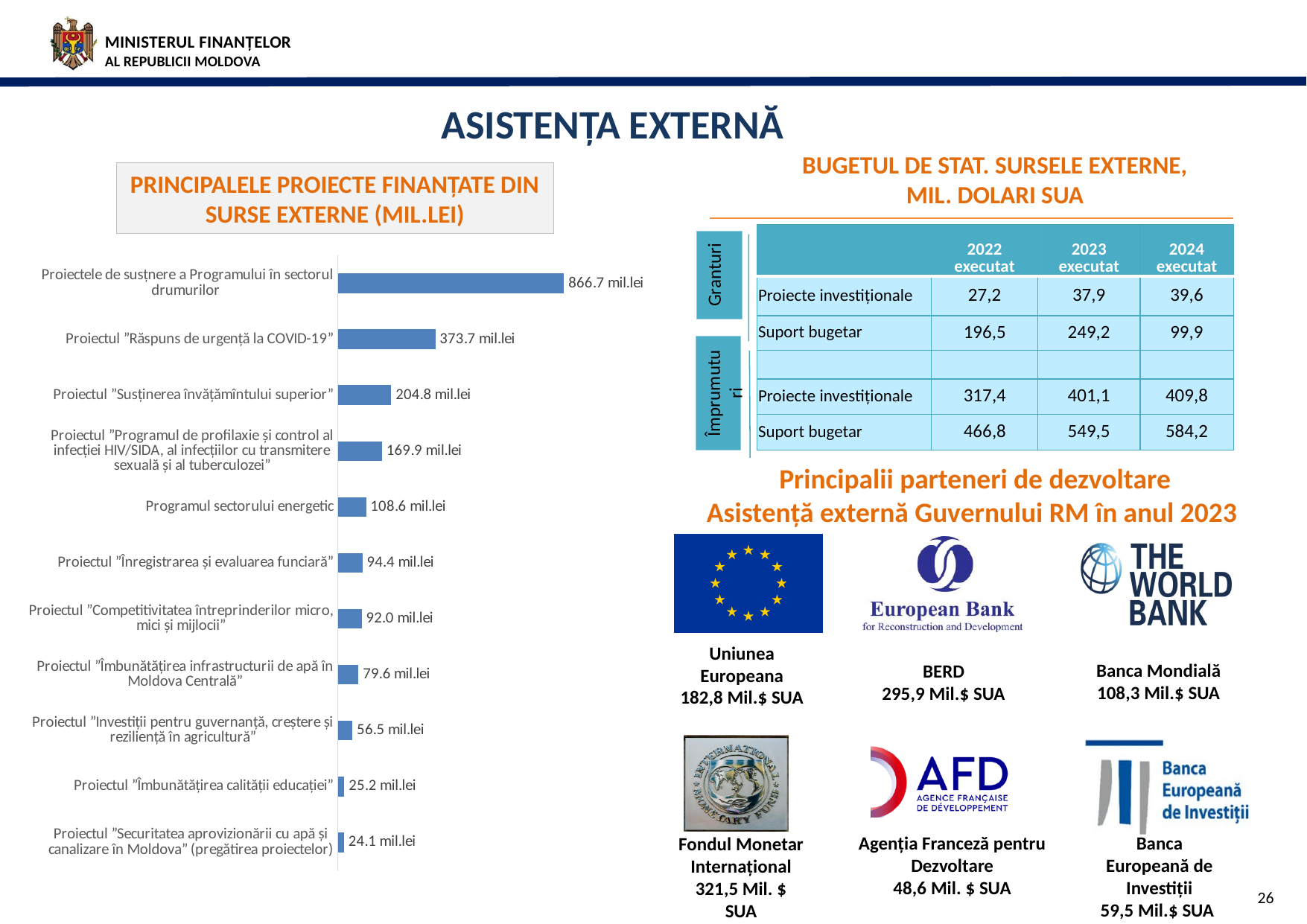
What is the value for "Proiectul "Îmbunătățirea calității educației""? 25.2 mil.lei Which is larger: the value for "Proiectul "Înregistrarea și evaluarea funciară"" or for "Proiectul "Competitivitatea întreprinderilor micro, mici și mijlocii""? Proiectul "Înregistrarea și evaluarea funciară" Which project has the lowest value in the chart? Proiectul "Securitatea aprovizionării cu apă și canalizare în Moldova" (pregătirea proiectelor) What is the value for "Programul sectorului energetic"? 108.6 mil.lei What is the value for "Proiectul "Răspuns de urgență la COVID-19""? 373.7 mil.lei How many projects are shown in the bar chart? 11 What is the difference between the value for the road sector programme (866.7 mil.lei) and the COVID-19 emergency response project (373.7 mil.lei)? 493.0 mil.lei What type of chart is shown on the slide? bar chart What is the difference between "Proiectul "Susținerea învățămîntului superior"" and the HIV/SIDA prevention and control programme? 34.9 mil.lei What is the title of the bar chart? PRINCIPALELE PROIECTE FINANȚATE DIN SURSE EXTERNE (MIL.LEI) What is the value for "Proiectele de susținere a Programului în sectorul drumurilor"? 866.7 mil.lei Which project has the highest value in the chart? Proiectele de susținere a Programului în sectorul drumurilor